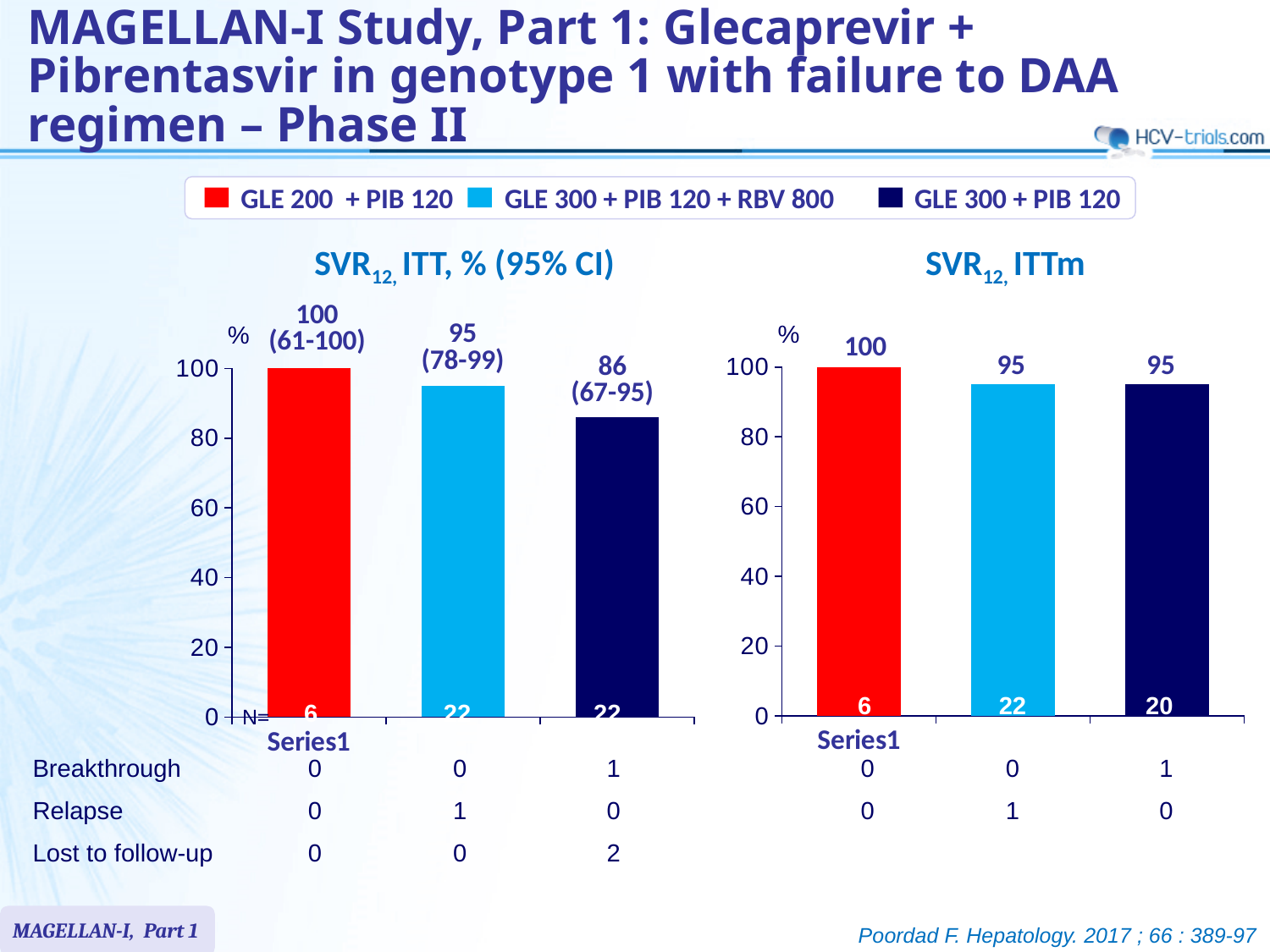
In the SVR12, ITTm chart, what is the SVR12 value for GLE 300 + PIB 120? 95 In the SVR12, ITT, % (95% CI) chart, which is larger: the SVR12 value for GLE 300 + PIB 120 + RBV 800 or for GLE 300 + PIB 120? GLE 300 + PIB 120 + RBV 800 Which colour represents GLE 300 + PIB 120 + RBV 800 in the legend? Light blue In the SVR12, ITT, % (95% CI) chart, what is the SVR12 value for GLE 300 + PIB 120? 86 What kind of chart is the SVR12, ITTm chart? Bar chart In the SVR12, ITT, % (95% CI) chart, what is the difference between the SVR12 values for GLE 200 + PIB 120 and GLE 300 + PIB 120? 14 In the SVR12, ITTm chart, what is the N for the GLE 300 + PIB 120 group? 20 In the SVR12, ITTm chart, which regimen has the highest SVR12 value? GLE 200 + PIB 120 In the SVR12, ITT, % (95% CI) chart, which regimen has the lowest SVR12 value? GLE 300 + PIB 120 In the SVR12, ITT, % (95% CI) chart, what is the 95% confidence interval shown for GLE 300 + PIB 120 + RBV 800? (78-99) How many series does the legend list? 3 In the SVR12, ITT, % (95% CI) chart, what is the SVR12 value for GLE 200 + PIB 120? 100